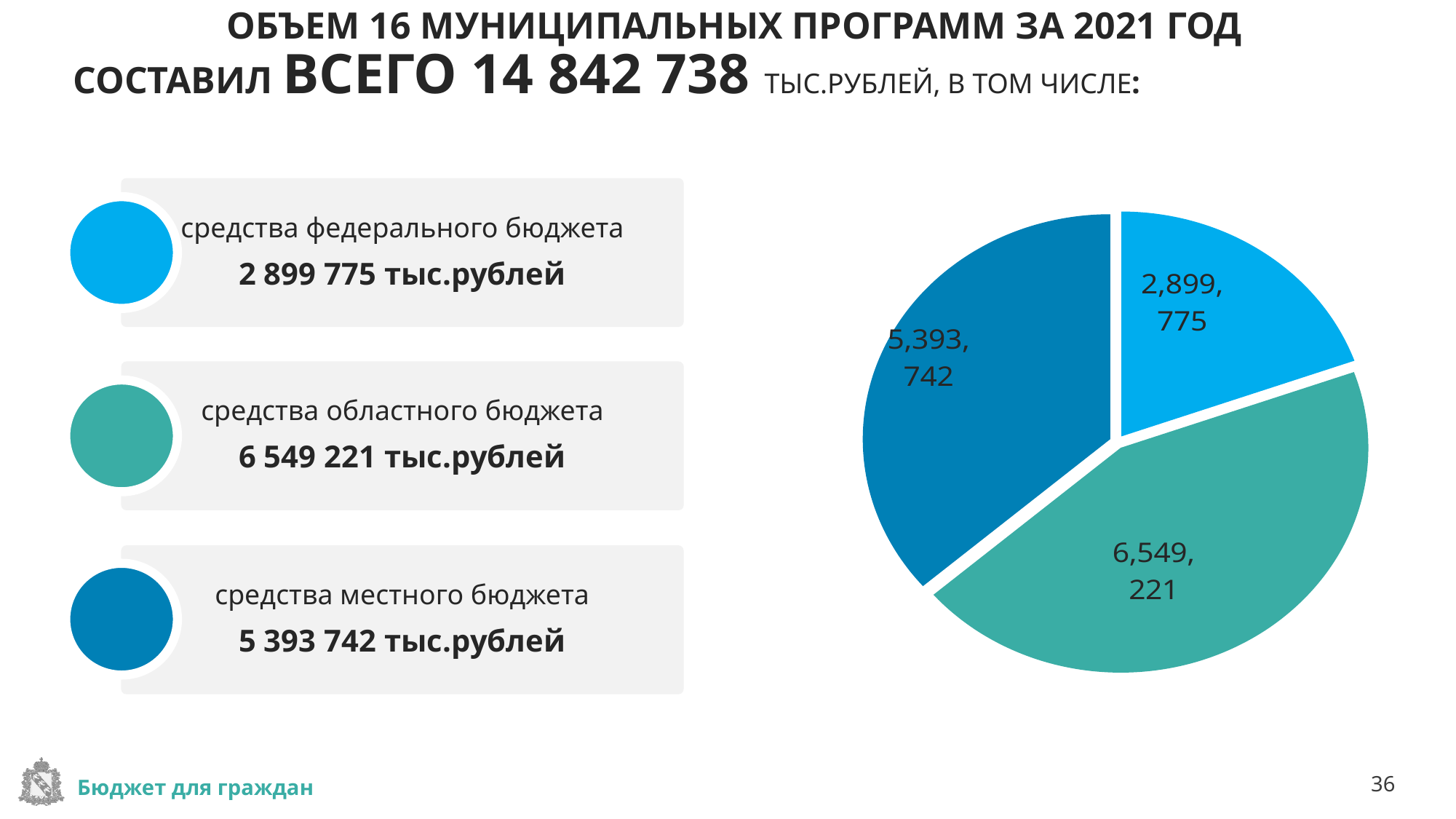
What value is shown for the light blue slice (средства федерального бюджета)? 2,899,775 What value is shown for the dark blue slice (средства местного бюджета)? 5,393,742 What is the difference between the областного бюджета value and the местного бюджета value in the pie chart? 1,155,479 Which is larger: the slice for средства местного бюджета or the slice for средства федерального бюджета? средства местного бюджета Which budget source has the smallest slice in the pie chart? средства федерального бюджета How many slices does the pie chart have? 3 Which budget source has the largest slice in the pie chart? средства областного бюджета What value is shown for the teal slice (средства областного бюджета)? 6,549,221 What is the total of all three slices in the pie chart? 14,842,738 What colour is the slice representing средства местного бюджета? Dark blue What kind of chart is shown on the slide? Pie chart What is the difference between the областного бюджета value and the федерального бюджета value in the pie chart? 3,649,446